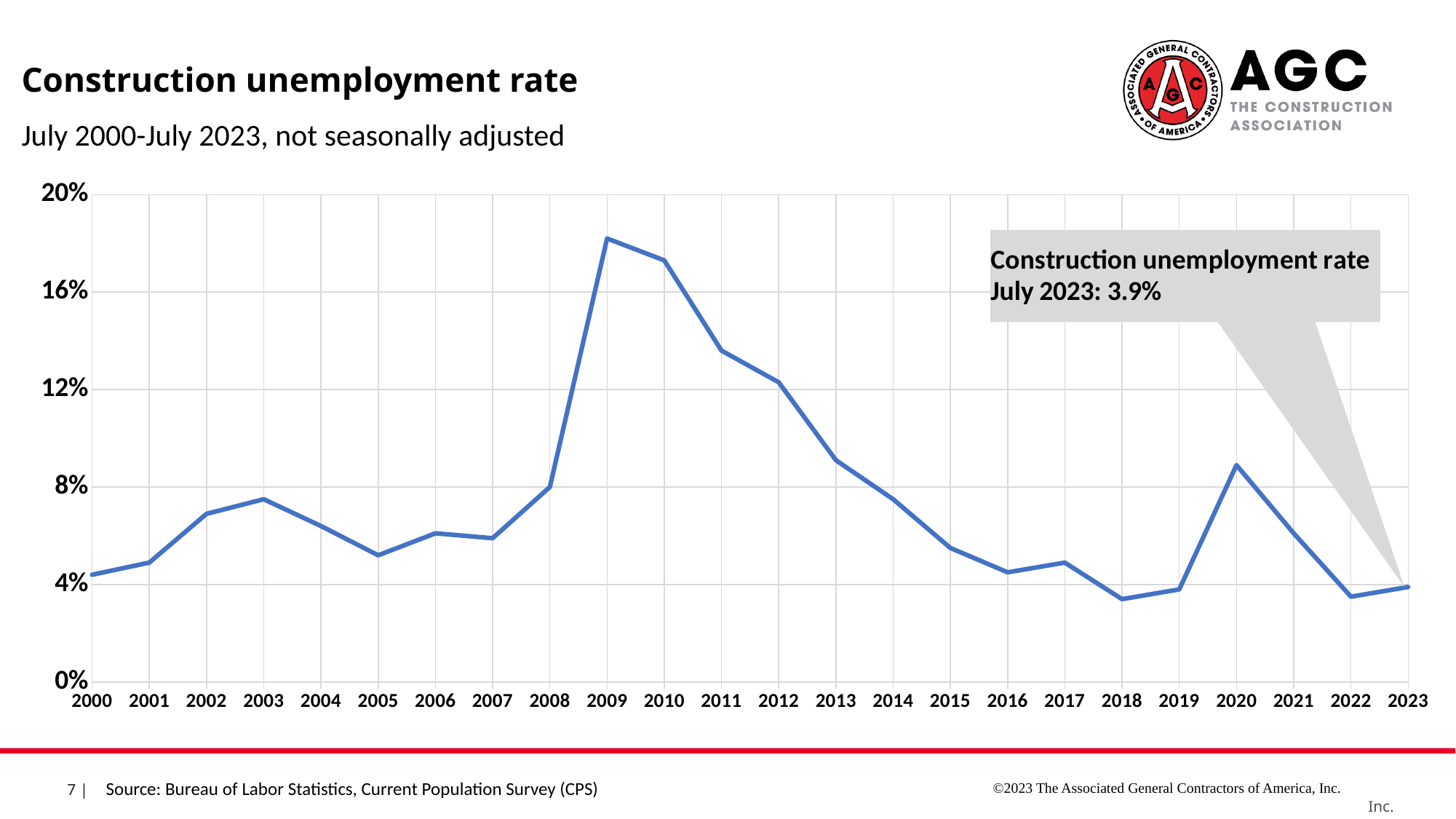
Is the value for 2009 greater or less than 16%? greater Which year has the higher construction unemployment rate, 2003 or 2005? 2003 What kind of chart is shown on the slide? Line chart In which year does the construction unemployment rate reach its highest point? 2009 What is the construction unemployment rate for July 2023 shown on the chart? 3.9% How many years are plotted on the x axis of the chart? 24 Does the construction unemployment rate rise or fall from 2009 to 2018? Fall Is the value for 2020 greater or less than 8%? greater What is the title of the chart on the slide? Construction unemployment rate Is the value for 2018 greater or less than 4%? less Which year has the higher construction unemployment rate, 2009 or 2020? 2009